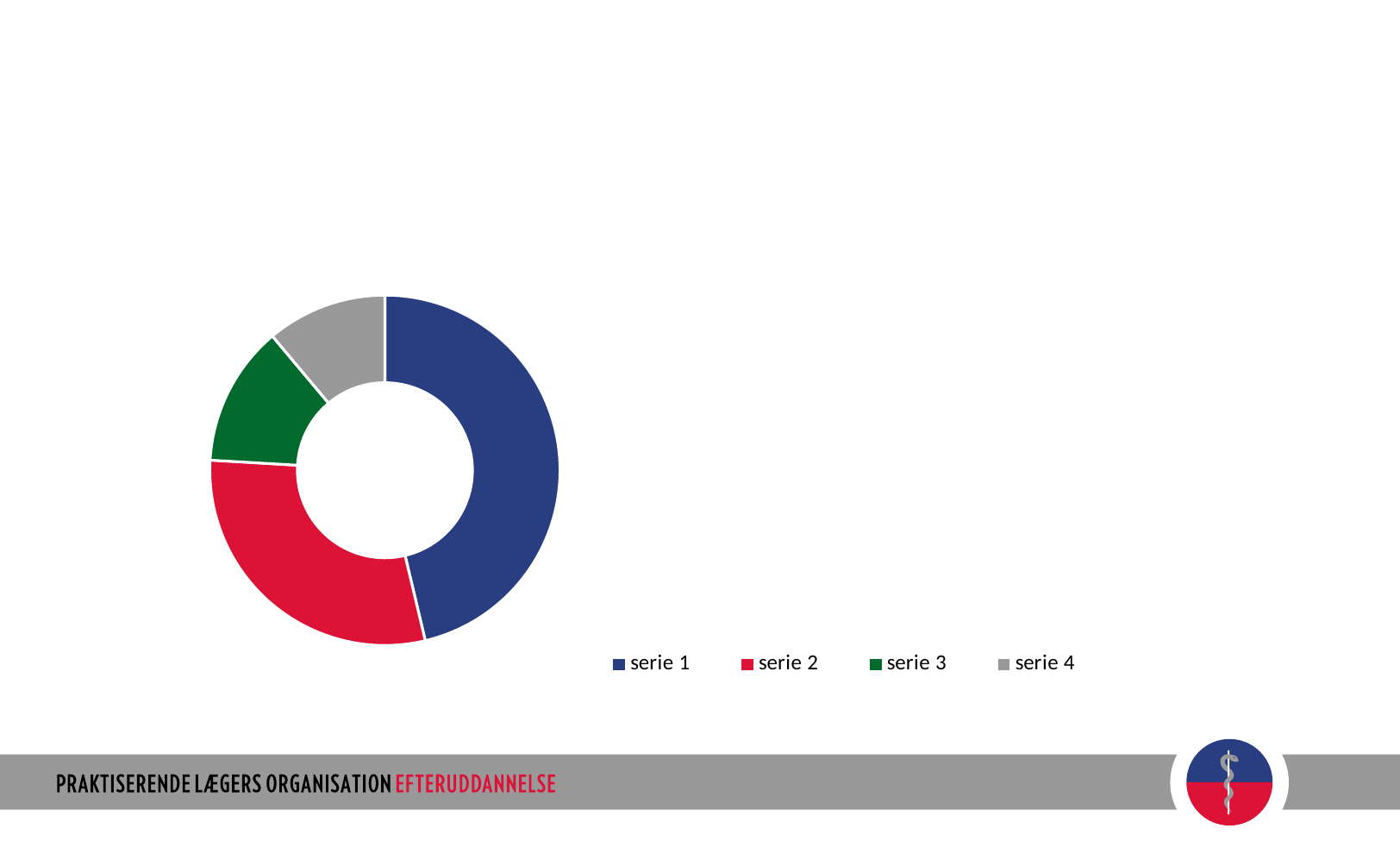
How many series does the legend list? 4 What colour represents serie 1 in the chart? Blue Which slice is larger, serie 2 or serie 4? serie 2 What colour represents serie 3 in the chart? Green How many slices does the doughnut chart have? 4 Which slice is larger, serie 1 or serie 2? serie 1 Which series has the largest slice in the doughnut chart? serie 1 Which slice is larger, serie 2 or serie 3? serie 2 What kind of chart is shown on the slide? Doughnut chart